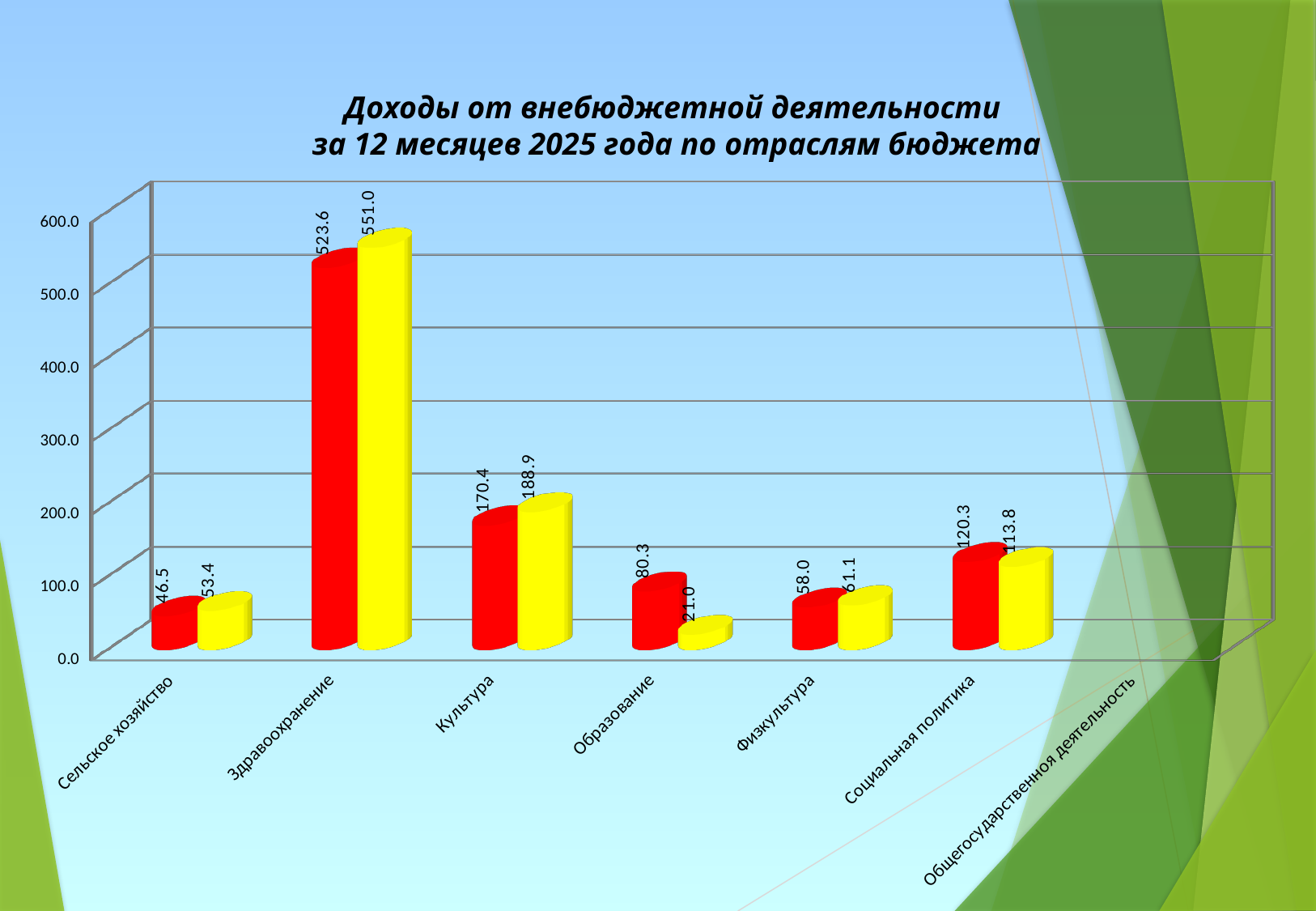
What is the value of the red bar for Социальная политика? 120.3 What type of chart is shown on the slide? bar chart Which is larger for Физкультура, the red bar or the yellow bar? the yellow bar What is the value of the yellow bar for Культура? 188.9 What is the value of the yellow bar for Образование? 21.0 Is the value of the red bar for Культура greater or less than 200.0? less What is the title of the chart? Доходы от внебюджетной деятельности за 12 месяцев 2025 года по отраслям бюджета Which category has the highest red bar? Здравоохранение How many category labels are shown on the horizontal axis? 7 What is the difference between the yellow and red bars for Здравоохранение? 27.4 What is the value of the red bar for Здравоохранение? 523.6 Which category has the lowest yellow bar? Образование